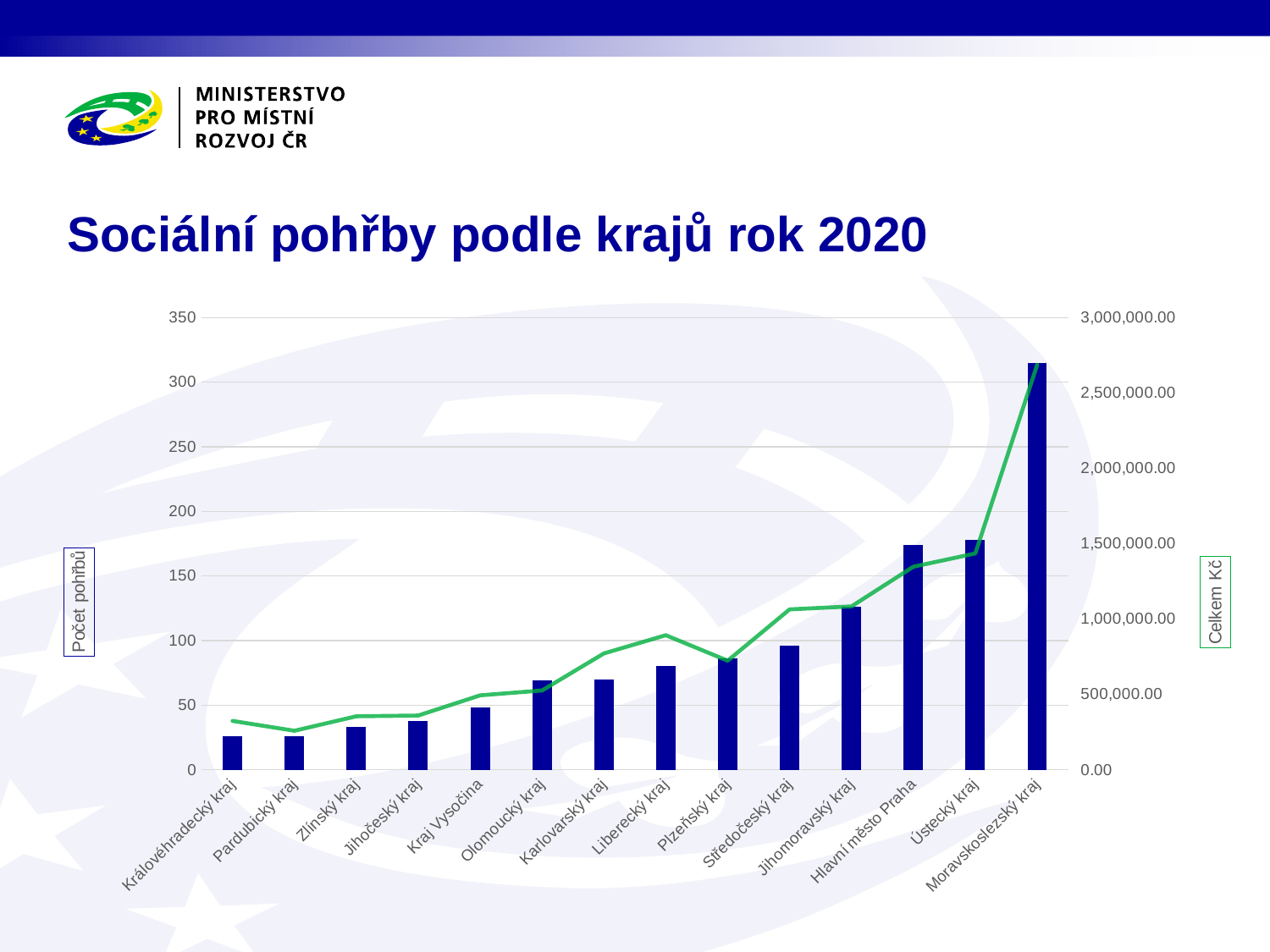
Is the bar value (Počet pohřbů) for Hlavní město Praha greater or less than 150? greater Which region has the highest bar (Počet pohřbů)? Moravskoslezský kraj What kind of chart is shown on the slide? A bar chart combined with a line What is the title of the right-hand vertical axis? Celkem Kč Is the bar value (Počet pohřbů) for Liberecký kraj greater or less than 100? less Is the bar value (Počet pohřbů) for Olomoucký kraj greater or less than 50? greater Which has the larger bar value (Počet pohřbů): Jihomoravský kraj or Středočeský kraj? Jihomoravský kraj What is the title of the chart? Sociální pohřby podle krajů rok 2020 How many regions (categories) are shown on the x axis? 14 Do the bar values generally rise or fall from left to right along the x axis? rise